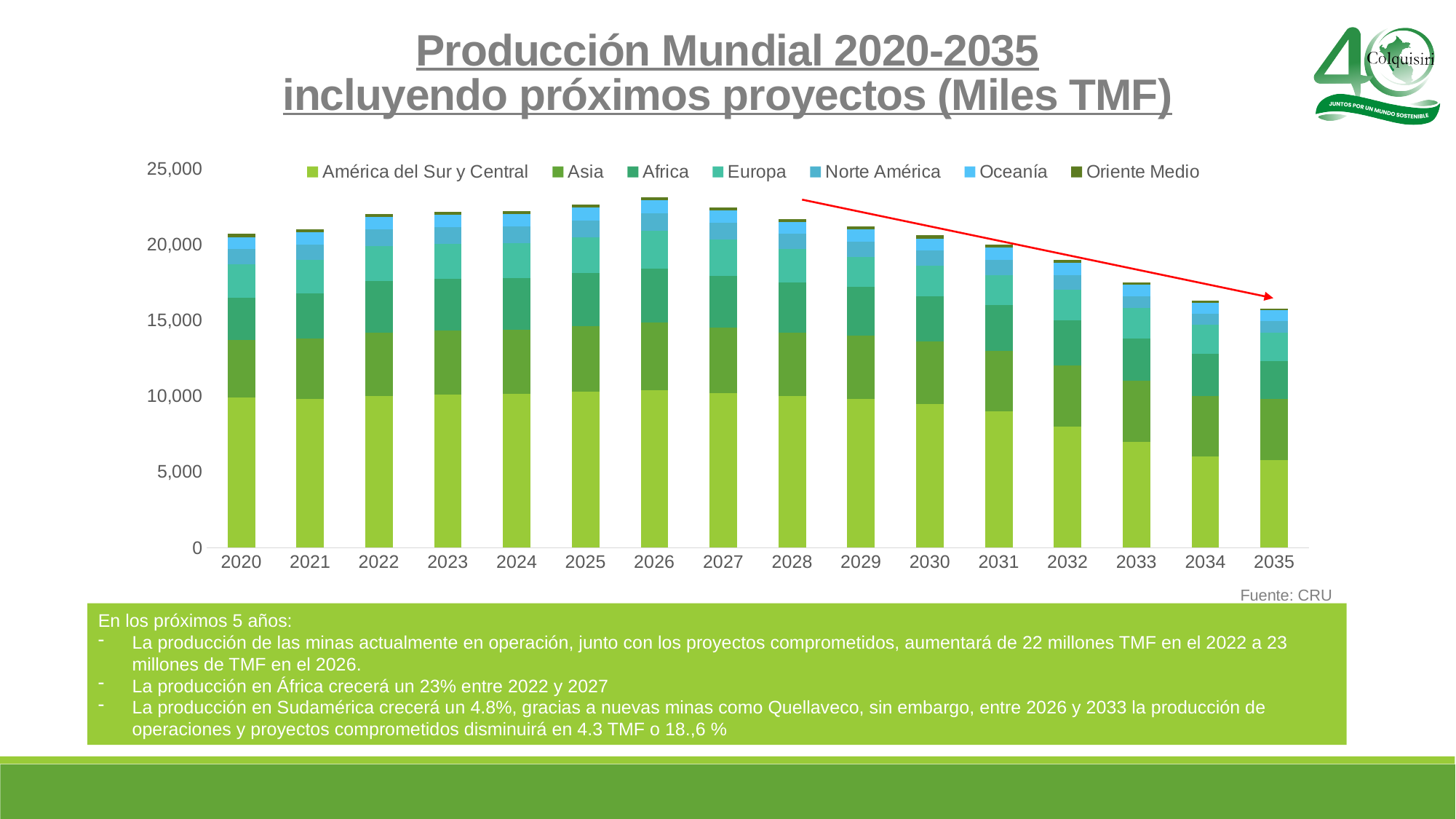
How many years (categories) are shown on the x axis of the chart? 16 What kind of chart is shown on the slide? stacked bar chart How many series does the chart legend list? 7 What source is cited below the chart? CRU Is the total production for 2035 greater or less than 20,000? less Do the total production values rise or fall from 2026 to 2035? fall Which year has the lowest total production in the chart? 2035 Which year has the highest total production in the chart? 2026 Is the value for América del Sur y Central in 2035 greater or less than 10,000? less Which year has the larger total production, 2022 or 2035? 2022 Is the total production for 2026 greater or less than 20,000? greater Which series is listed first in the chart legend? América del Sur y Central